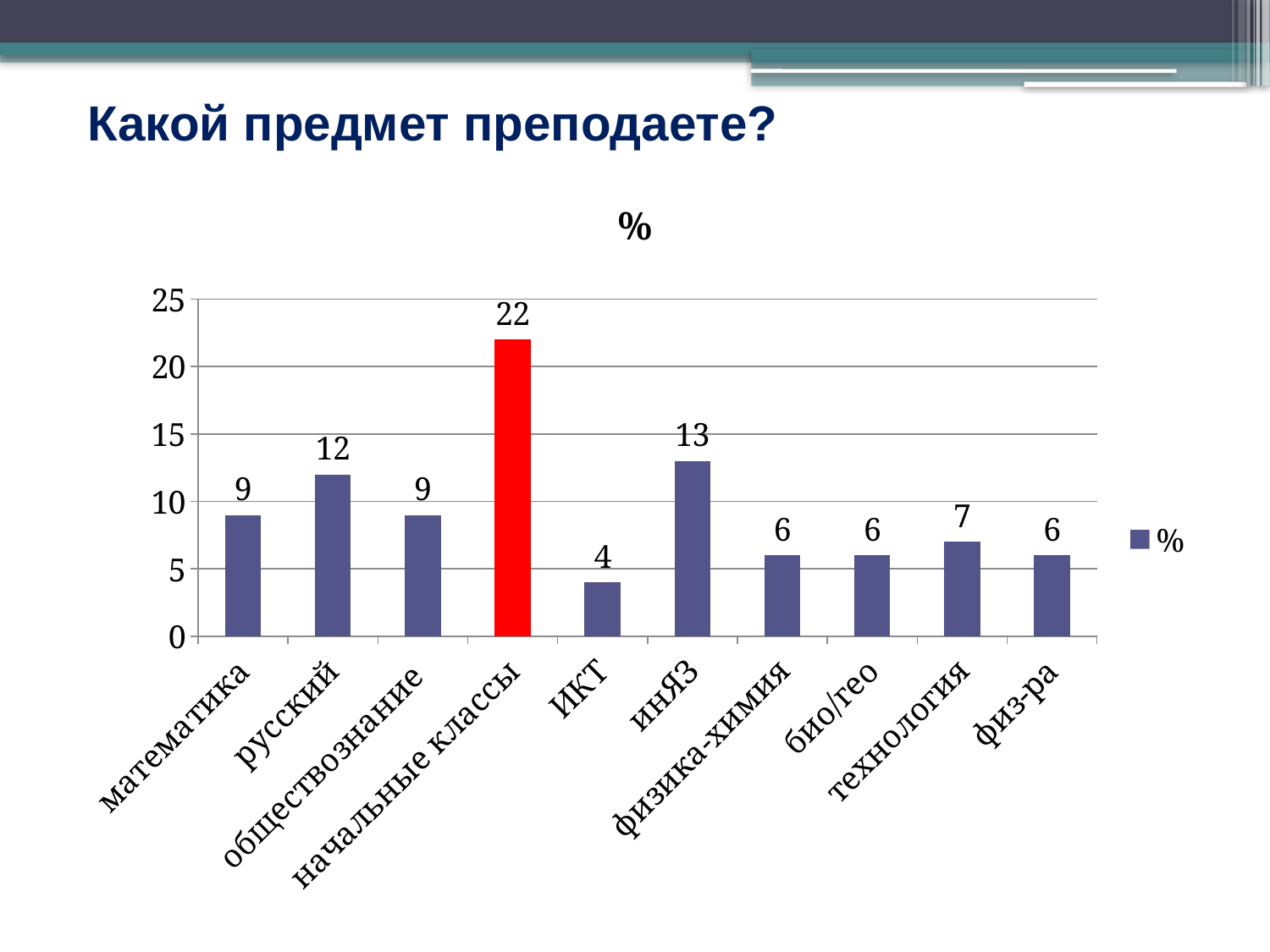
Which category has the lowest value? ИКТ Which category has the highest value? начальные классы What is the value for начальные классы? 22 What is the value for ИКТ? 4 What is the value for инЯЗ? 13 What kind of chart is shown on the slide? bar chart What is the difference between the values for начальные классы and русский? 10 Is the value for математика greater or less than 10? less Which bar is coloured red? начальные классы What is the value for технология? 7 How many categories are shown on the x axis? 10 Which is larger, the value for русский or the value for инЯЗ? инЯЗ